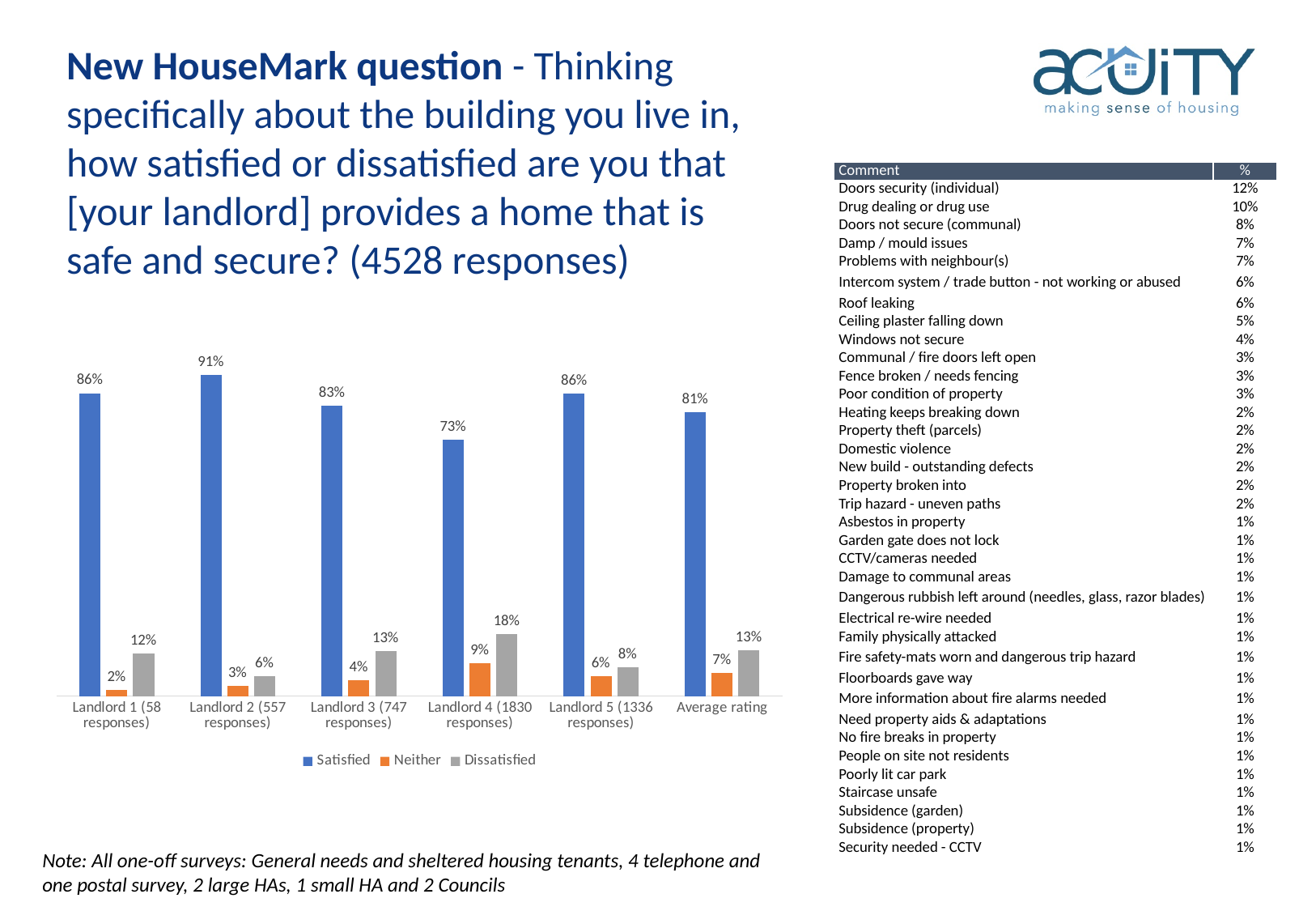
Which category has the highest Satisfied value? Landlord 2 (557 responses) What is the difference between the Satisfied values for Landlord 2 (557 responses) and Landlord 4 (1830 responses)? 18% What kind of chart is shown on the slide? Bar chart How many series does the chart legend list? 3 What is the Satisfied value for Landlord 2 (557 responses)? 91% How many categories are shown on the x axis of the chart? 6 What is the Dissatisfied value for Landlord 4 (1830 responses)? 18% Which category has the lowest Satisfied value? Landlord 4 (1830 responses) What are the three series listed in the chart legend? Satisfied, Neither, Dissatisfied Which category has the lowest Neither value? Landlord 1 (58 responses) Which is larger, the Dissatisfied value for Landlord 1 (58 responses) or for Landlord 5 (1336 responses)? Landlord 1 (58 responses) What is the Neither value for the Average rating category? 7%